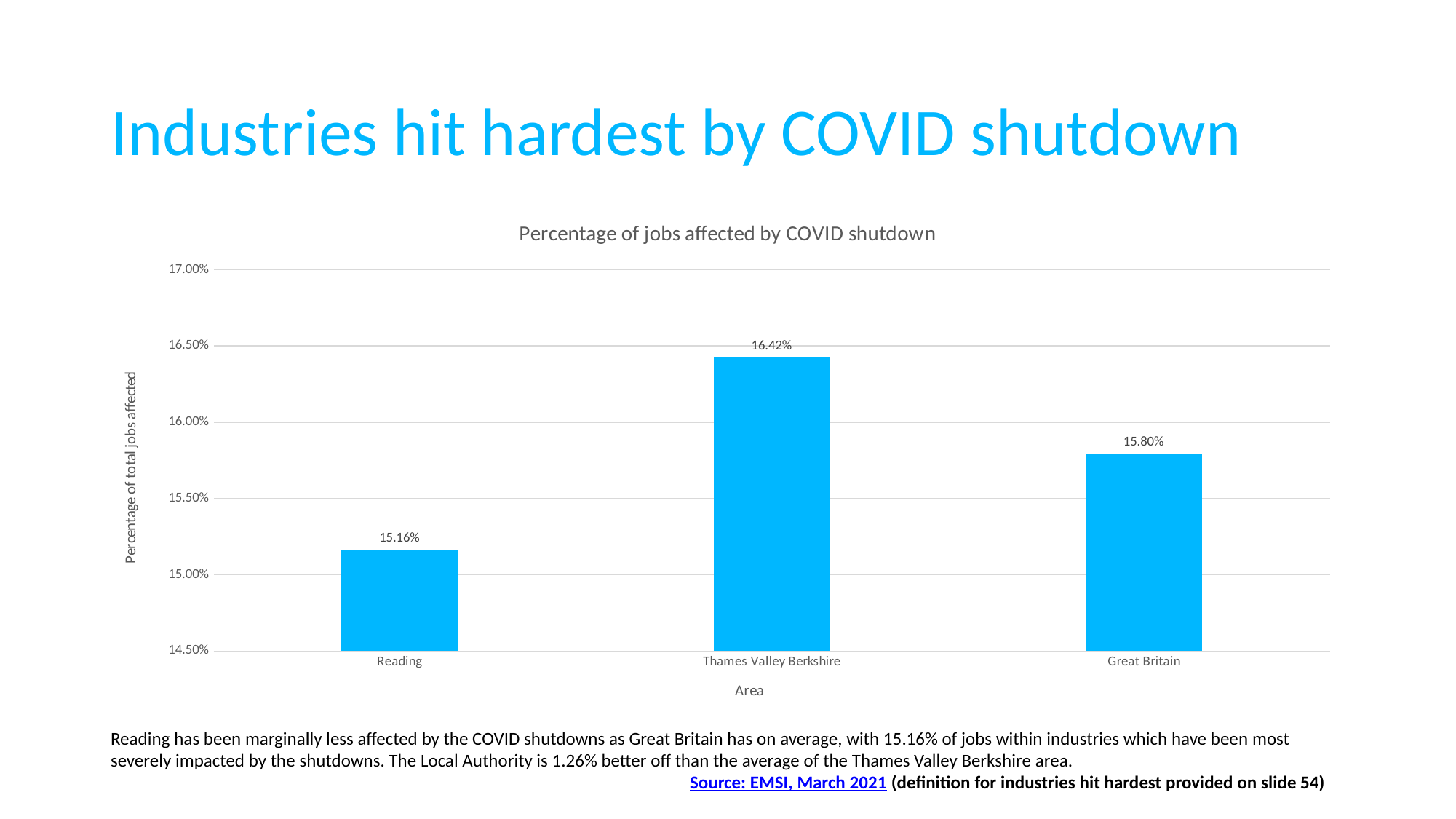
What kind of chart is shown? Bar chart What is the difference between the values for Great Britain and Reading? 0.64% How many areas are shown on the chart? 3 What is the title of the chart? Percentage of jobs affected by COVID shutdown Which area has the lowest percentage of jobs affected? Reading What is the value for Reading? 15.16% What is the value for Great Britain? 15.80% What is the value for Thames Valley Berkshire? 16.42% Which area has the highest percentage of jobs affected? Thames Valley Berkshire Which is larger, the value for Great Britain or the value for Reading? Great Britain What is the difference between the values for Thames Valley Berkshire and Reading? 1.26% Is the value for Thames Valley Berkshire greater or less than 16.00%? greater